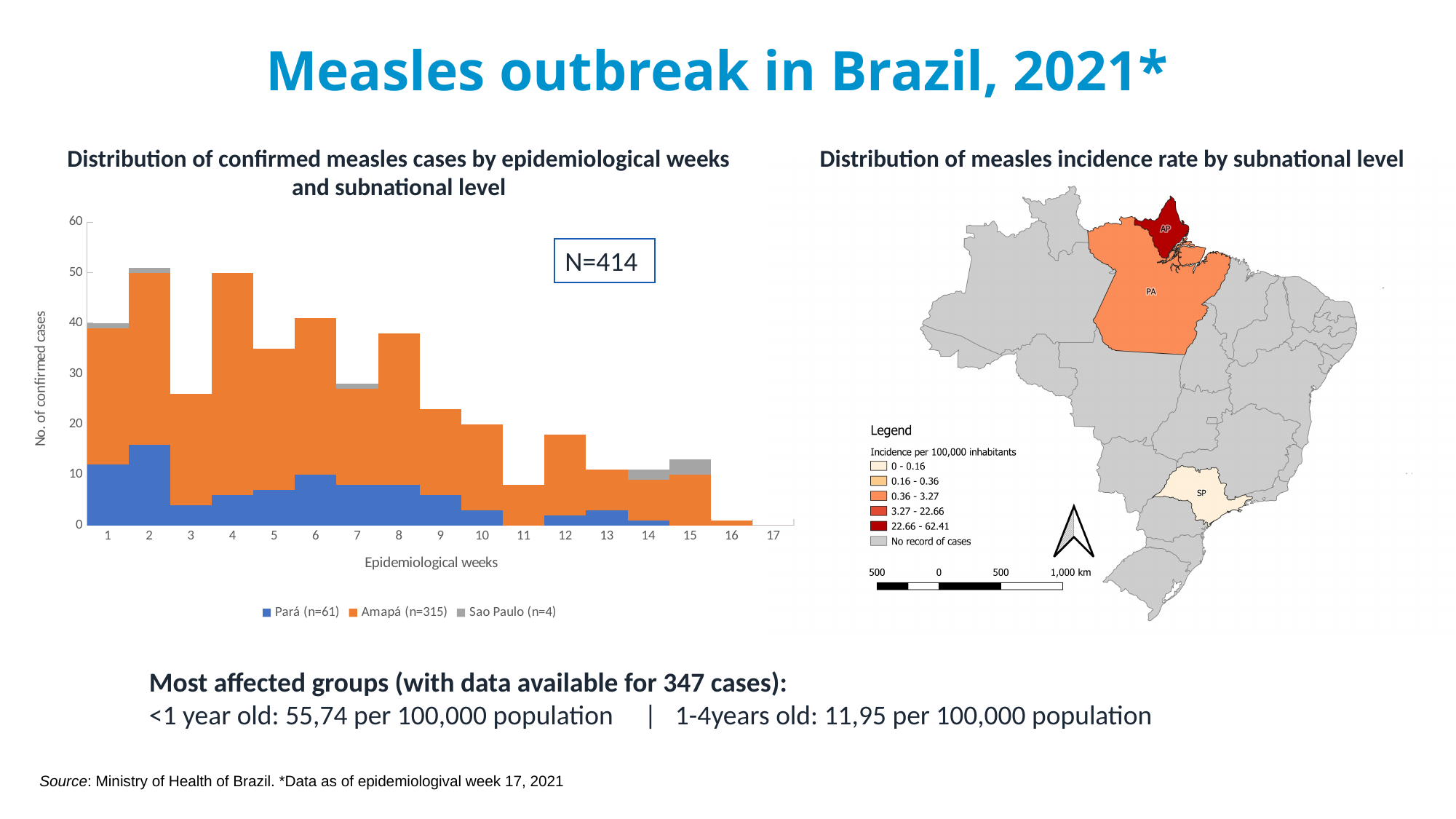
In the bar chart on the left, which week has more confirmed cases, week 3 or week 4? Week 4 In the bar chart on the left, is the total number of confirmed cases in week 3 greater or less than 30? less In the bar chart on the left, which colour represents Pará? Blue In the map 'Distribution of measles incidence rate by subnational level', which state falls in the highest incidence category (22.66 - 62.41)? AP In the bar chart on the left, how many series does the legend list? 3 In the bar chart on the left, what is the total number of cases (N) shown in the box? N=414 In the bar chart on the left, how many cases does the legend give for Amapá? 315 In the bar chart on the left, how many epidemiological weeks are shown on the x axis? 17 In the bar chart on the left, is the total number of confirmed cases in week 11 greater or less than 10? less In the bar chart on the left, do the total confirmed cases generally rise or fall from week 8 to week 16? Fall In the bar chart on the left, is the total number of confirmed cases in week 5 greater or less than 30? greater What kind of chart is the 'Distribution of confirmed measles cases by epidemiological weeks and subnational level' chart? Stacked bar chart